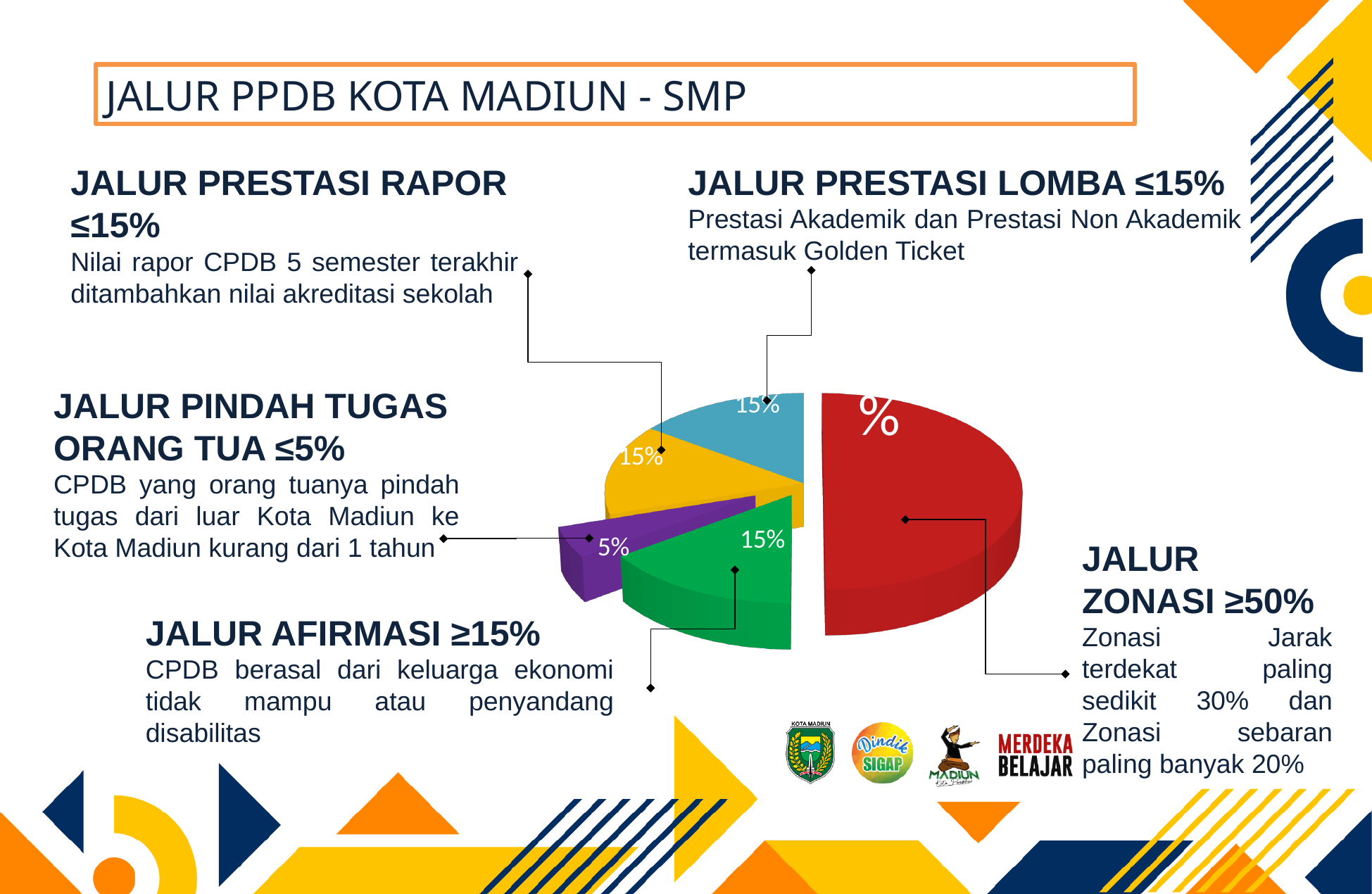
What value is printed on the green slice of the pie chart? 15% Which is larger in the pie chart, the green slice or the purple slice? the green slice What value is printed on the purple slice of the pie chart? 5% What colour is the slice connected to the 'JALUR AFIRMASI ≥15%' text? green What kind of chart is shown on the slide? pie chart Which slice of the pie chart is the largest? the red slice (Jalur Zonasi) Which slice of the pie chart is the smallest? the purple slice (Jalur Pindah Tugas Orang Tua), 5% What value is printed on the teal (light blue) slice of the pie chart? 15% How many slices does the pie chart have? 5 What value is printed on the yellow slice of the pie chart? 15% What is the difference between the green slice value and the purple slice value in the pie chart? 10% How many slices in the pie chart are labelled 15%? 3